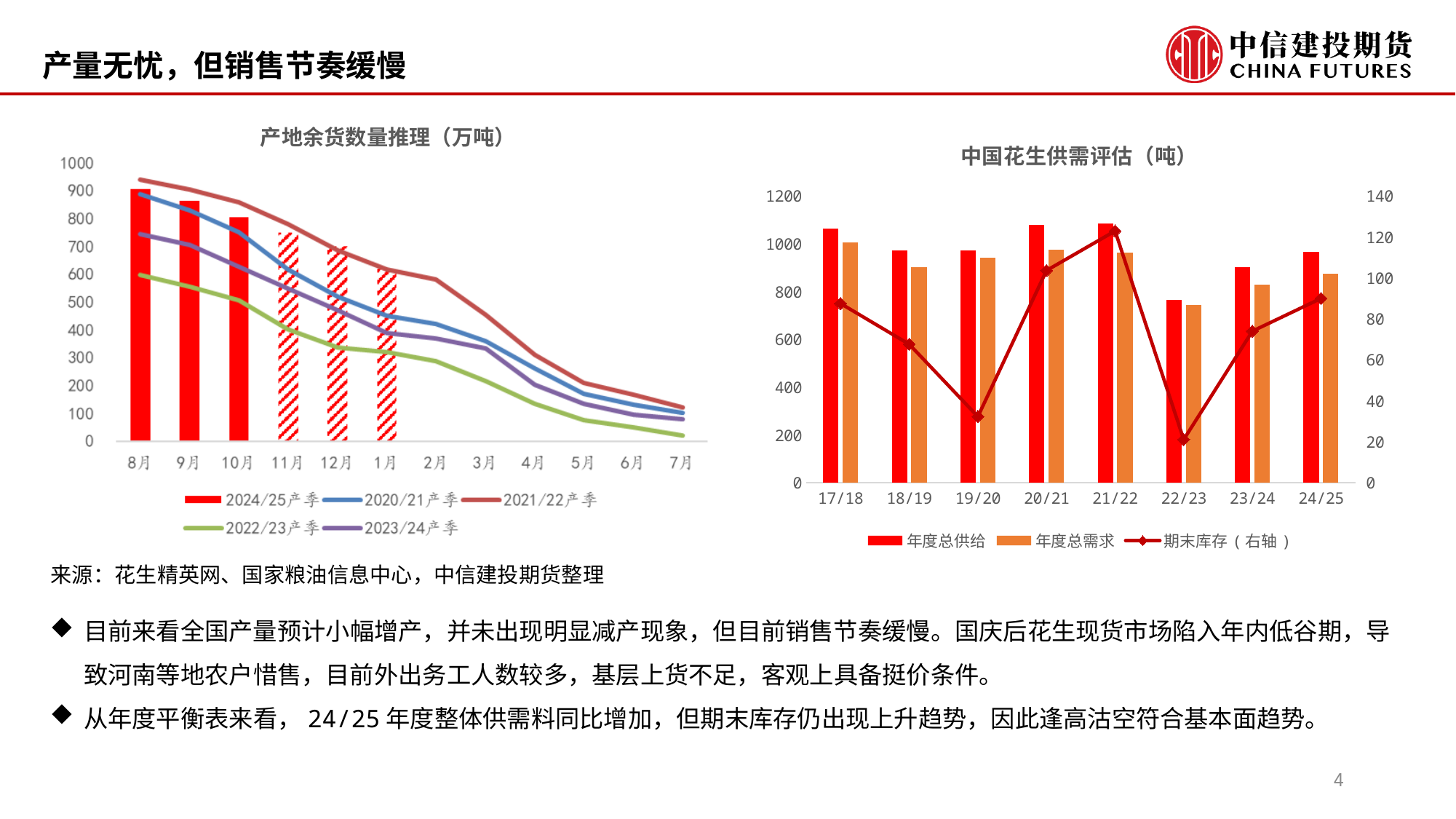
In the right chart (中国花生供需评估), is 年度总供给 or 年度总需求 larger in 24/25? 年度总供给 In the left chart (产地余货数量推理), which series has the highest value in 8月? 2021/22产季 How many months are shown on the x axis of the left chart (产地余货数量推理)? 12 How many series does the legend of the left chart (产地余货数量推理) list? 5 How many years are shown on the x axis of the right chart (中国花生供需评估)? 8 In the left chart (产地余货数量推理), is the 2024/25产季 bar for 8月 greater or less than 800? greater In the right chart (中国花生供需评估), which year has the lowest 年度总供给? 22/23 In the left chart (产地余货数量推理), is the 2024/25产季 bar for 1月 greater or less than 700? less In the left chart (产地余货数量推理), do the values rise or fall from 8月 to 7月? fall What kind of chart is the left chart titled 产地余货数量推理（万吨）? A combined bar and line chart In the left chart (产地余货数量推理), which series has the lowest value in 8月? 2022/23产季 In the right chart (中国花生供需评估), which year has the highest 期末库存? 21/22